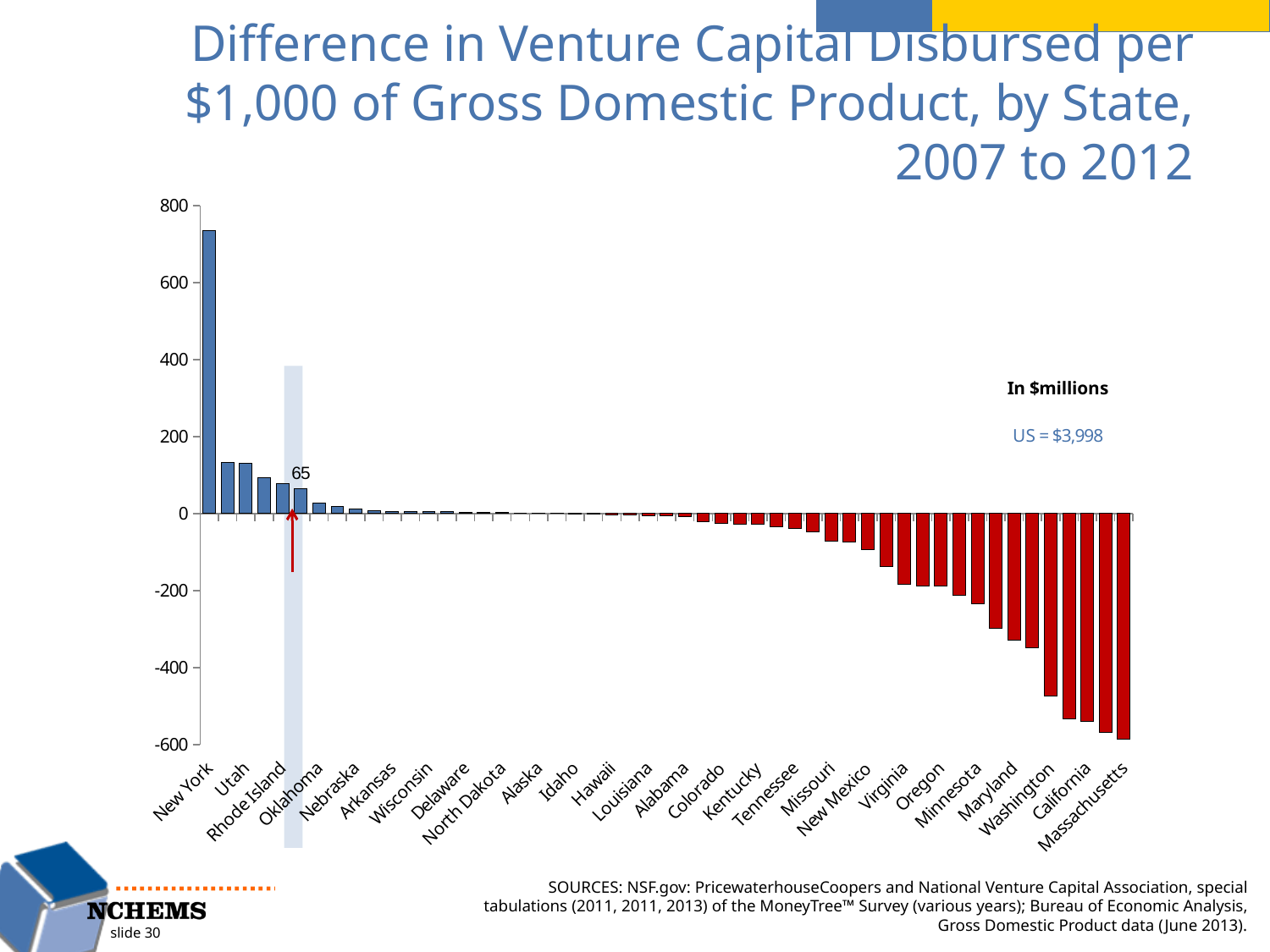
Is the value for Massachusetts greater or less than -400? less What US total value is noted on the chart? US = $3,998 Which has the larger value, Oklahoma or Massachusetts? Oklahoma Which has the larger value, Utah or Oklahoma? Utah What kind of chart is shown on the slide? bar chart Which state has the lowest value in the chart? Massachusetts Do the values rise or fall moving from left to right across the states? fall Is the value for New York greater or less than 600? greater Is the value for California greater or less than -400? less Which state has the highest value in the chart? New York